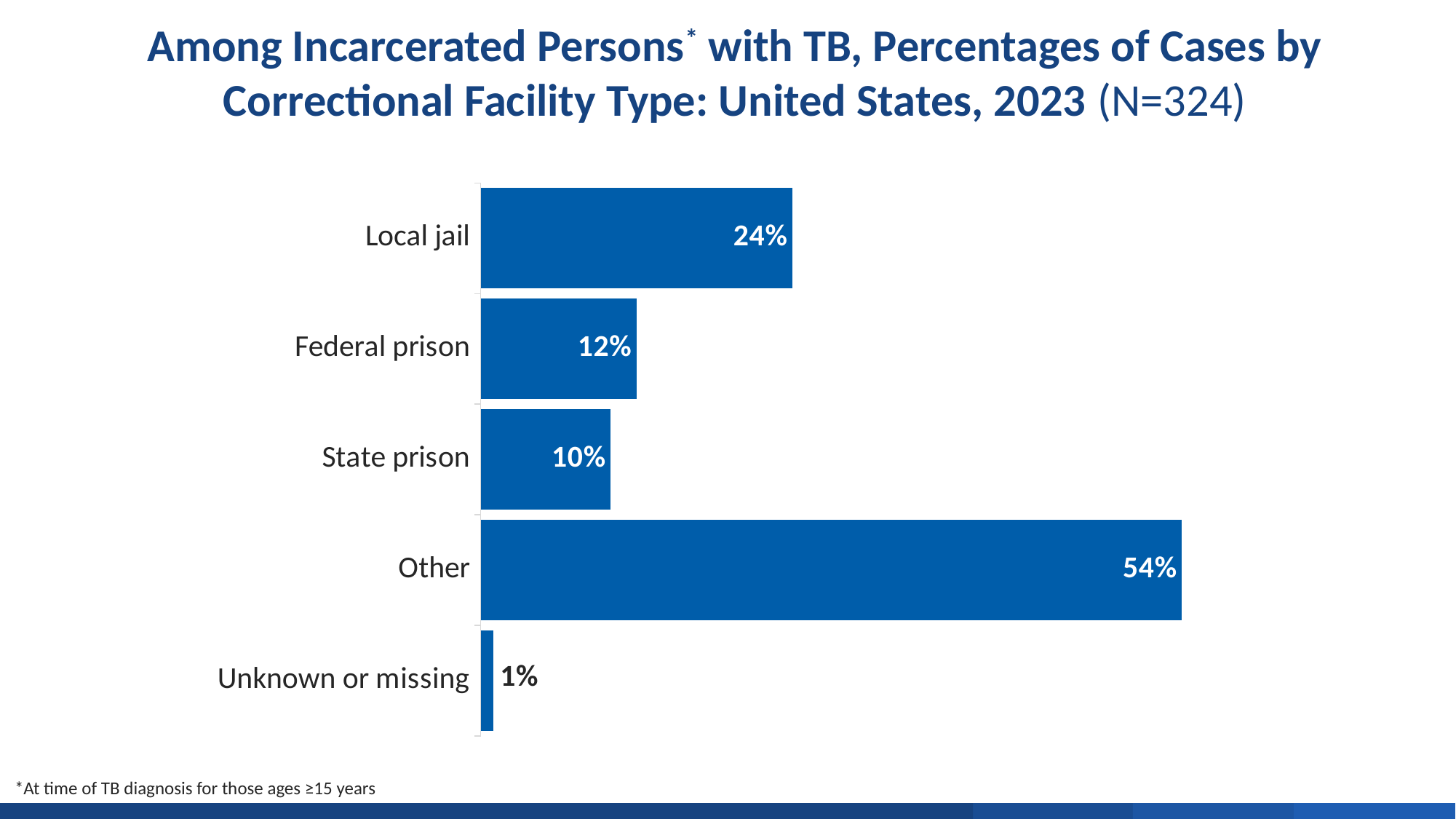
What is the total number of cases (N) stated in the chart title? 324 What type of chart is shown on the slide? Bar chart Which correctional facility type has the highest percentage of cases? Other How many facility type categories are shown in the chart? 5 What percentage of TB cases among incarcerated persons were in a local jail? 24% What percentage of cases were in a state prison? 10% What is the difference in percentage points between 'Other' and 'Local jail'? 30 What percentage of cases fall under the 'Other' facility type? 54% Which category has the lowest percentage of cases? Unknown or missing Which has a larger percentage of cases, federal prison or state prison? Federal prison What percentage of cases have an unknown or missing facility type? 1% What percentage of cases were in a federal prison? 12%